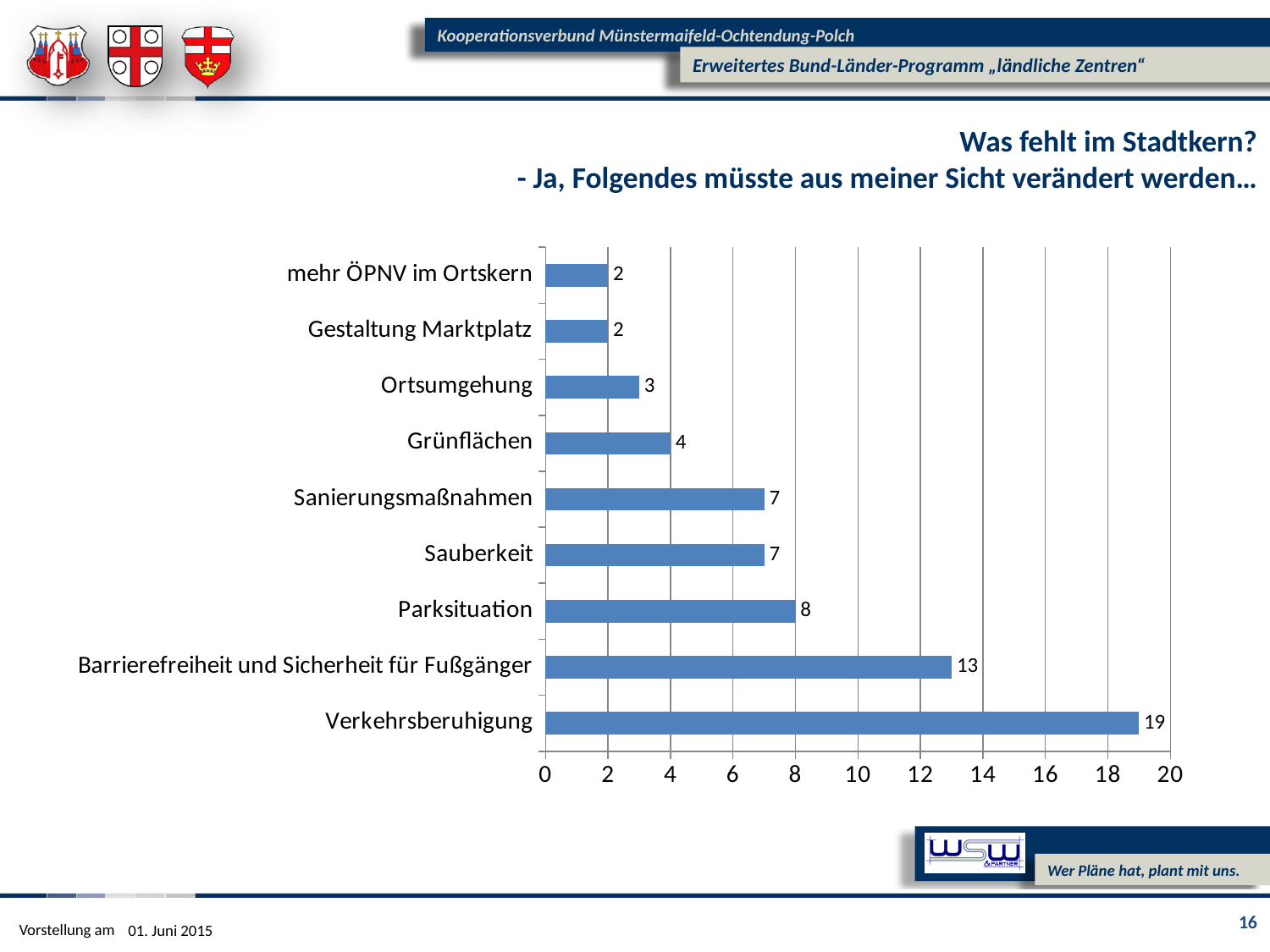
What is the highest value shown on the x axis? 20 What kind of chart is shown on the slide? bar chart What is the value for Verkehrsberuhigung? 19 How many categories are shown in the chart? 9 What is the value for Ortsumgehung? 3 Which is larger, the value for Parksituation or the value for Sauberkeit? Parksituation Which category has the highest value? Verkehrsberuhigung What is the value for Parksituation? 8 Is the value for Barrierefreiheit und Sicherheit für Fußgänger greater or less than 10? greater What is the difference between the values for Verkehrsberuhigung and Barrierefreiheit und Sicherheit für Fußgänger? 6 What is the value for Barrierefreiheit und Sicherheit für Fußgänger? 13 What is the value for Grünflächen? 4